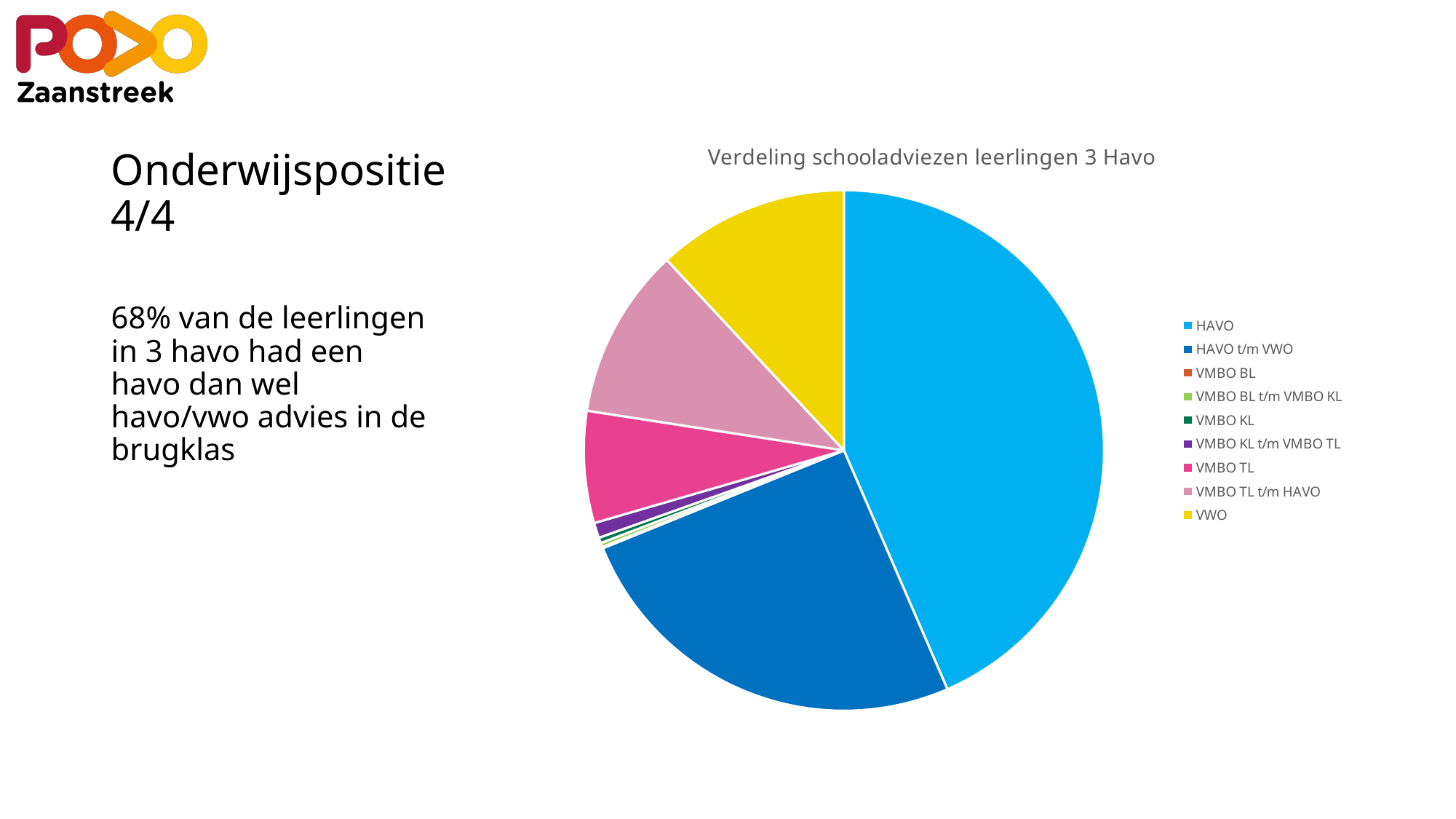
What is the title of the chart? Verdeling schooladviezen leerlingen 3 Havo Which slice is larger, VMBO TL or VMBO KL? VMBO TL How many categories does the legend of the pie chart list? 9 Which slice is larger, VWO or VMBO TL? VWO Which colour represents VWO in the pie chart? yellow Which category has the largest slice in the pie chart? HAVO Which slice is larger, HAVO or HAVO t/m VWO? HAVO What kind of chart is shown on the slide? pie chart